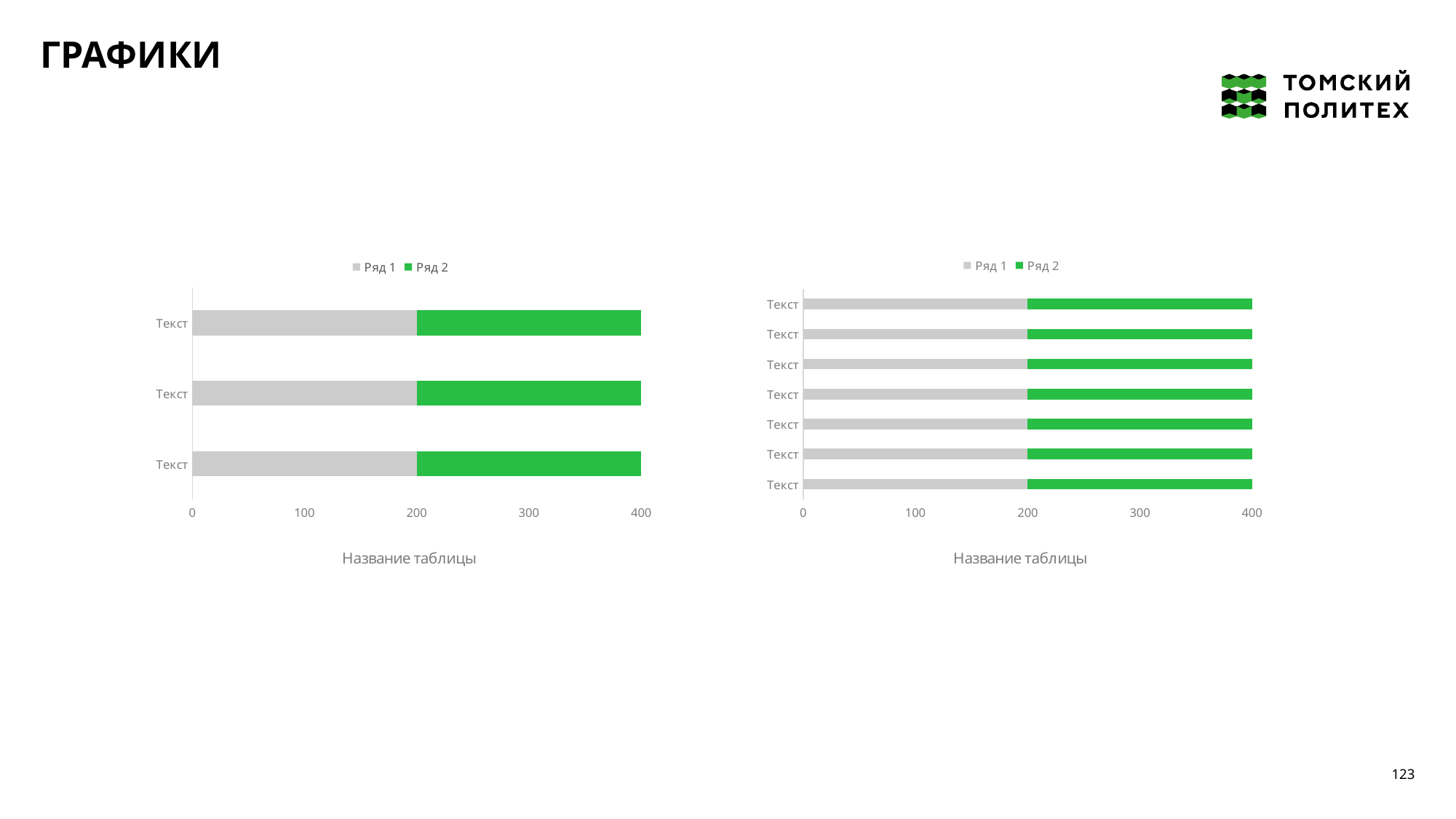
In the chart on the left side of the slide, is the Ряд 1 value of the bottom bar greater or less than 300? less In the chart on the left side of the slide, what is the value of Ряд 1 for the top bar? 200 How many bars (categories) does the chart on the right side of the slide show? 7 What is the highest value shown on the horizontal axis of the chart on the right side of the slide? 400 How many bars (categories) does the chart on the left side of the slide show? 3 How many series does the legend of the chart on the left side of the slide list? 2 In the chart on the right side of the slide, is the total of the top bar greater or less than 300? greater What are the series names in the legend of the chart on the right side of the slide? Ряд 1, Ряд 2 What kind of chart is the chart on the left side of the slide? bar chart In the chart on the right side of the slide, what is the total of the bottom stacked bar? 400 In the chart on the left side of the slide, what is the difference between the total of the top bar and the total of the bottom bar? 0 In the chart on the left side of the slide, what is the total of the top stacked bar? 400